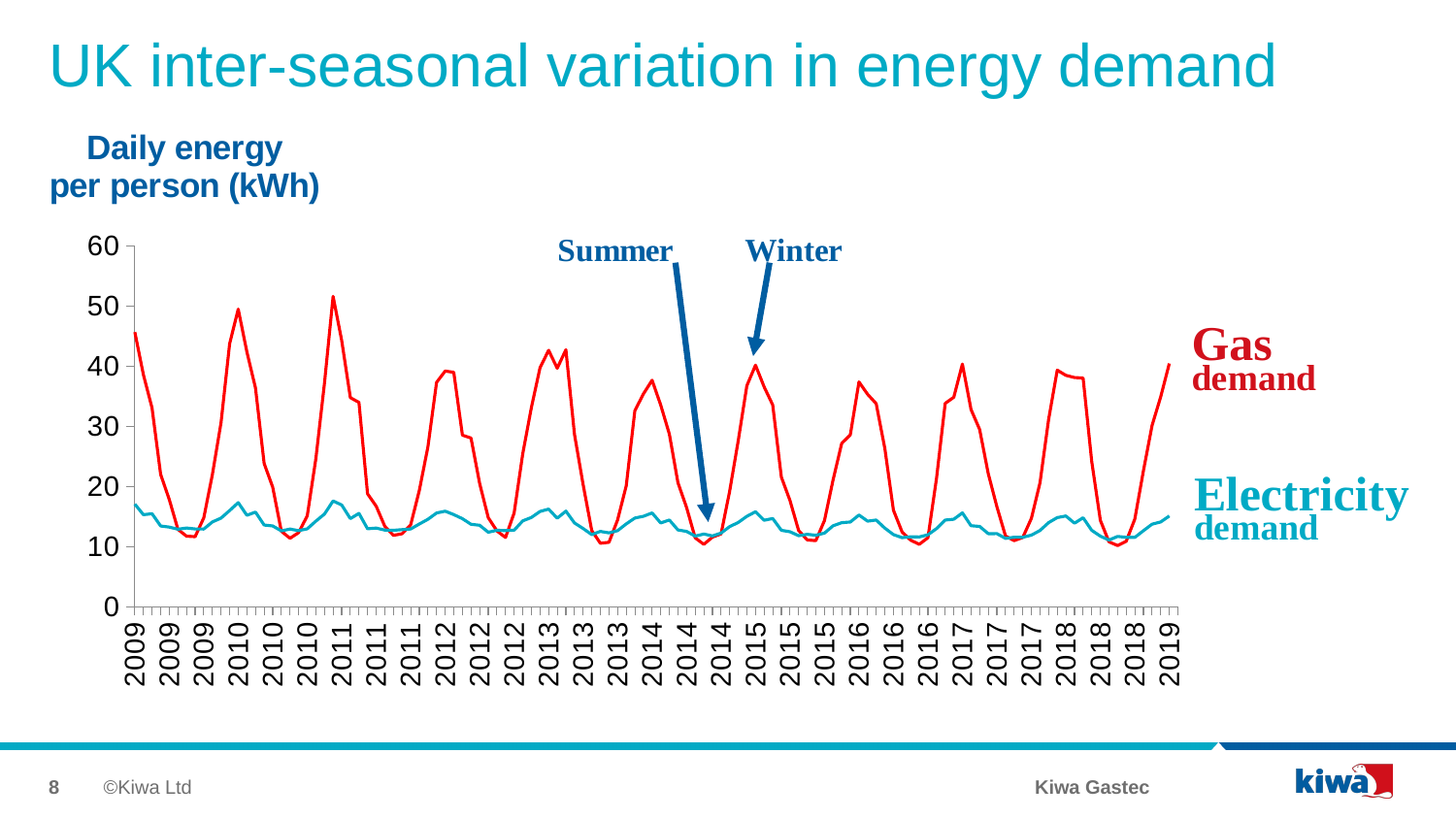
Is the gas demand at the winter 2015 peak greater or less than 30? greater Is the highest gas demand peak on the chart greater or less than 40? greater Is the gas demand at the summer 2014 trough greater or less than 20? less What is the title of the slide's chart? Daily energy per person (kWh) What quantity does the vertical axis measure, according to its label? Daily energy per person (kWh) Which series reaches higher values at the winter peaks, gas demand or electricity demand? Gas demand How many data series are plotted on the chart? 2 What is the first year shown on the horizontal axis? 2009 Do the winter peaks of gas demand generally rise or fall between 2011 and 2018? fall What kind of chart is shown on the slide? line chart Which series shows the larger seasonal variation, gas demand or electricity demand? Gas demand